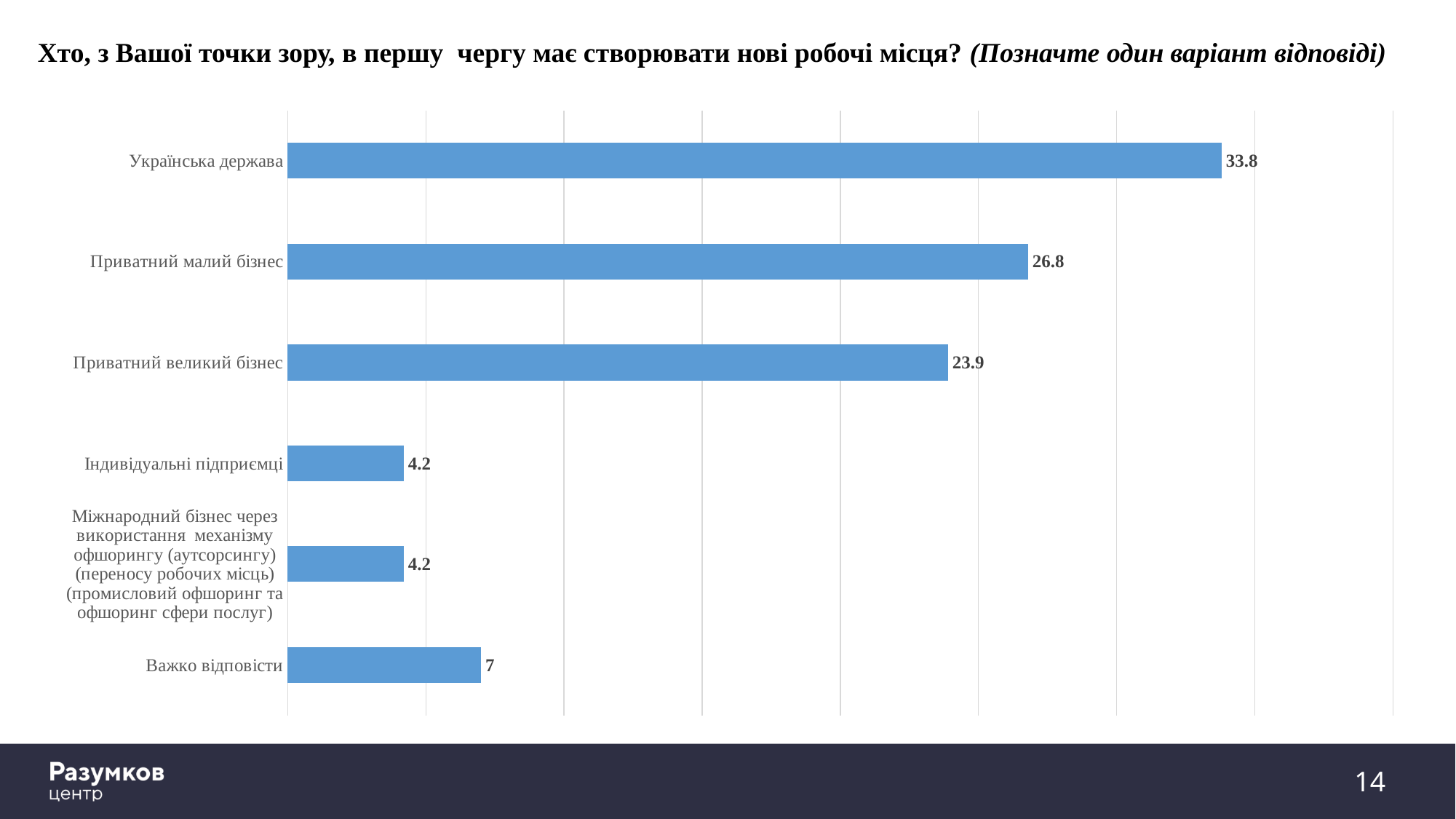
What is the difference between the values for Приватний малий бізнес and Приватний великий бізнес? 2.9 What is the difference between the values for Українська держава and Приватний малий бізнес? 7 Which is larger, the value for Приватний малий бізнес or Приватний великий бізнес? Приватний малий бізнес Which category has the highest value? Українська держава What value is shown for Індивідуальні підприємці? 4.2 How many categories are shown in the chart? 6 What value is shown for Українська держава? 33.8 What kind of chart is shown on the slide? Bar chart What value is shown for Приватний малий бізнес? 26.8 Which is larger, the value for Важко відповісти or Індивідуальні підприємці? Важко відповісти What value is shown for Важко відповісти? 7 What value is shown for Приватний великий бізнес? 23.9